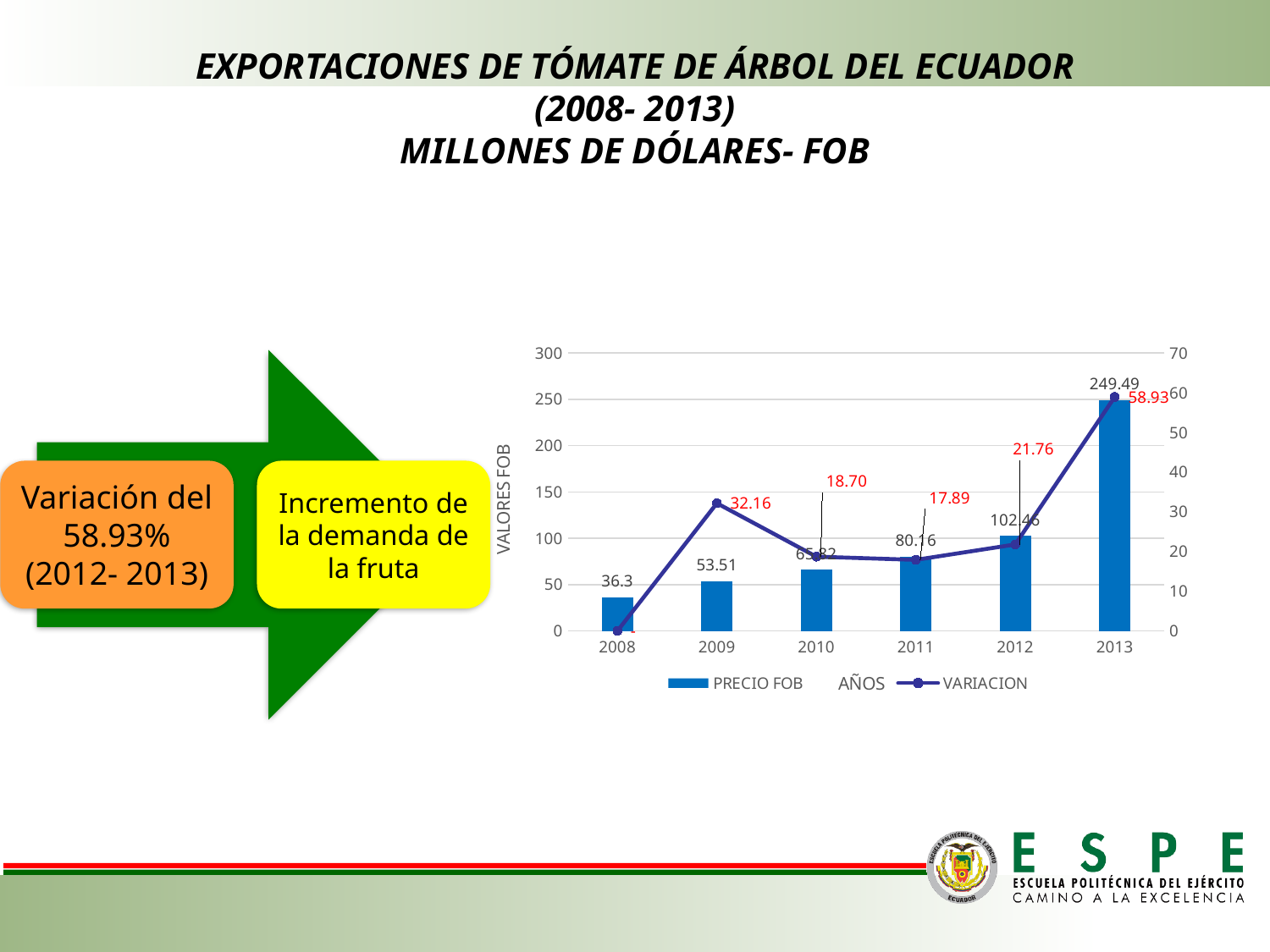
What is the difference in PRECIO FOB between 2013 and 2012? 147.03 Which year has the lowest PRECIO FOB? 2008 What is the difference in VARIACION between 2013 and 2012? 37.17 What is the PRECIO FOB value for 2008? 36.3 What is the VARIACION value for 2009? 32.16 What is the PRECIO FOB value for 2013? 249.49 Which year has the highest PRECIO FOB? 2013 Is the PRECIO FOB value for 2011 greater or less than 100? less What is the VARIACION value for 2012? 21.76 How many series does the legend list? 2 How many years are shown on the x axis? 6 Which is larger, the VARIACION for 2009 or for 2010? 2009